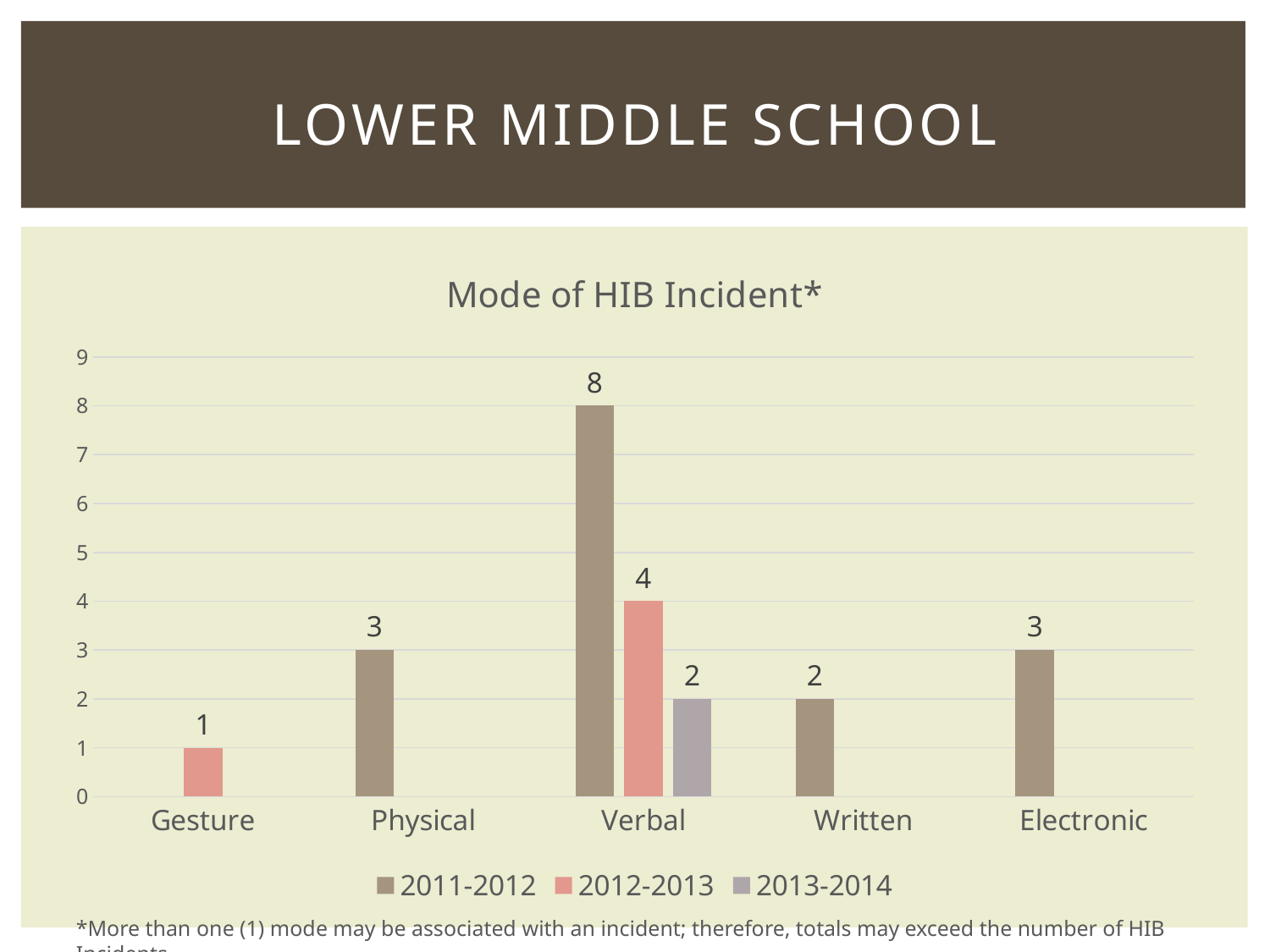
Which category has the highest value in the 2011-2012 series? Verbal What is the difference between the 2011-2012 and 2012-2013 values for Verbal? 4 What is the title of the chart? Mode of HIB Incident* Which is larger: the 2011-2012 value for Physical or the 2011-2012 value for Written? Physical What is the value for Gesture in the 2012-2013 series? 1 Which series is shown in the legend with a pink/red colour? 2012-2013 What is the value for Electronic in the 2011-2012 series? 3 What is the value for Verbal in the 2013-2014 series? 2 How many series does the legend list? 3 What kind of chart is shown on the slide? Bar chart How many categories are shown on the x axis? 5 What is the value for Verbal in the 2011-2012 series? 8